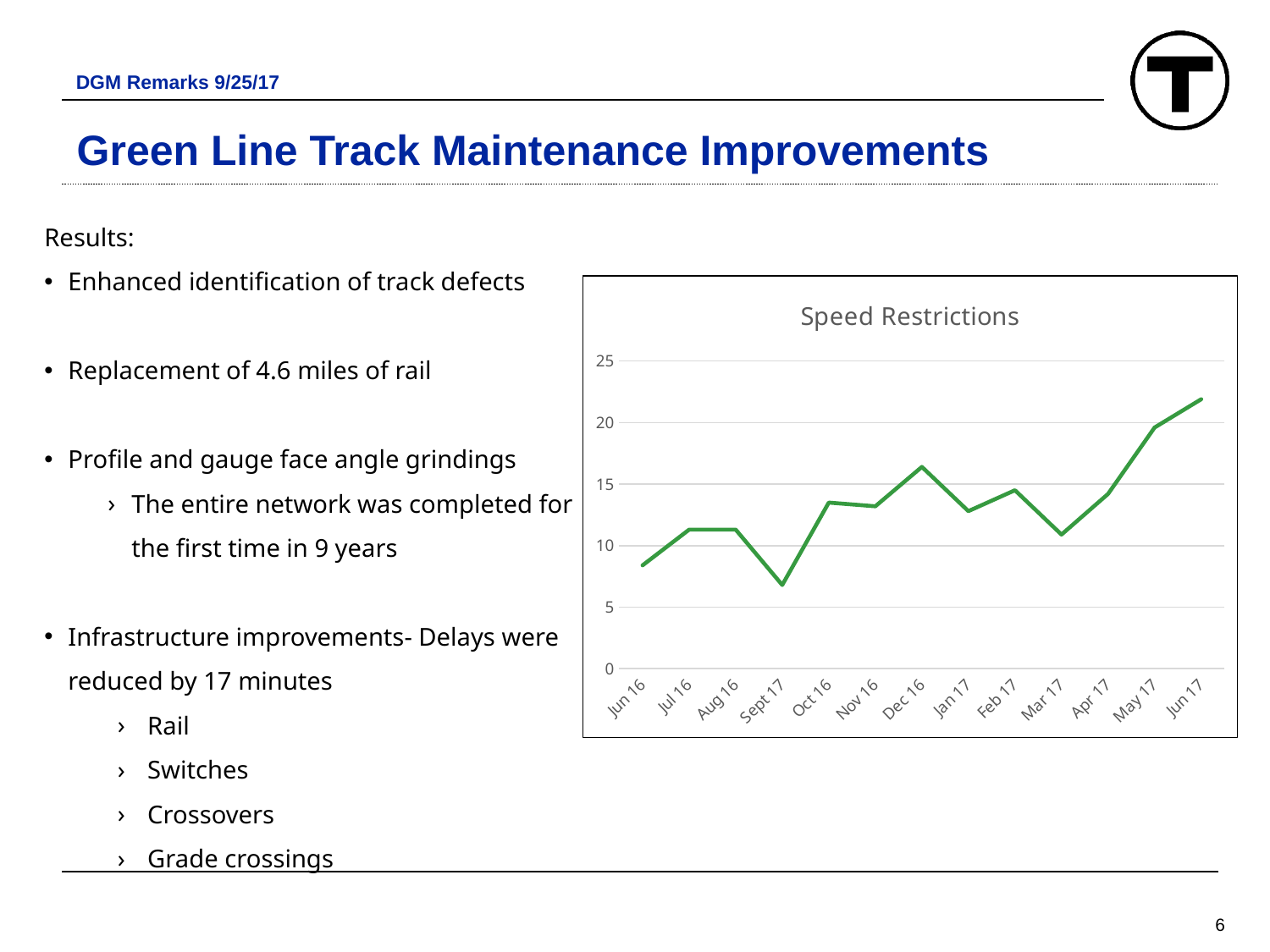
What kind of chart is shown on the slide? line chart Is the value for Jun 17 greater or less than 20? greater What is the title of the chart? Speed Restrictions Is the value for Jun 16 greater or less than 10? less Which is larger, the value for Dec 16 or the value for Jan 17? Dec 16 Do the values rise or fall from Mar 17 to Jun 17? rise Which is larger, the value for May 17 or the value for Mar 17? May 17 How many points are plotted on the Speed Restrictions line? 13 Which month has the highest value for Speed Restrictions? Jun 17 Is the value for Dec 16 greater or less than 15? greater Which month has the lowest value for Speed Restrictions? Sept 17